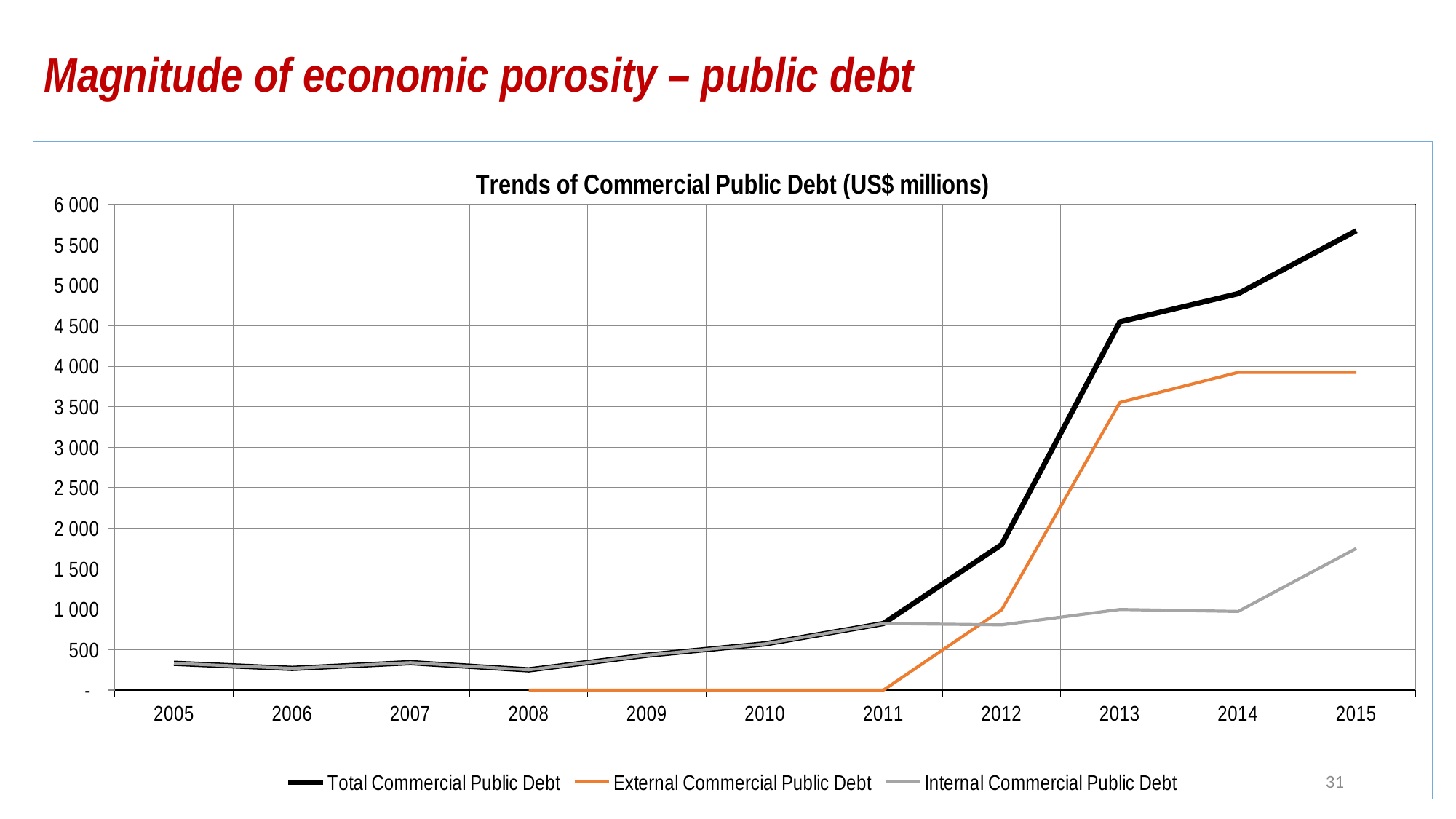
Does Total Commercial Public Debt rise or fall between 2011 and 2015? rise Is the value for Total Commercial Public Debt in 2015 greater or less than 5 500? greater In which year is Total Commercial Public Debt highest? 2015 Which series is drawn with an orange line? External Commercial Public Debt What is the title of the chart? Trends of Commercial Public Debt (US$ millions) What kind of chart is shown on the slide? line chart Is the value for Internal Commercial Public Debt in 2014 greater or less than 1 500? less How many series does the legend list? 3 Is the value for External Commercial Public Debt in 2013 greater or less than 3 000? greater Which is larger in 2015, External Commercial Public Debt or Internal Commercial Public Debt? External Commercial Public Debt How many years are shown on the x axis? 11